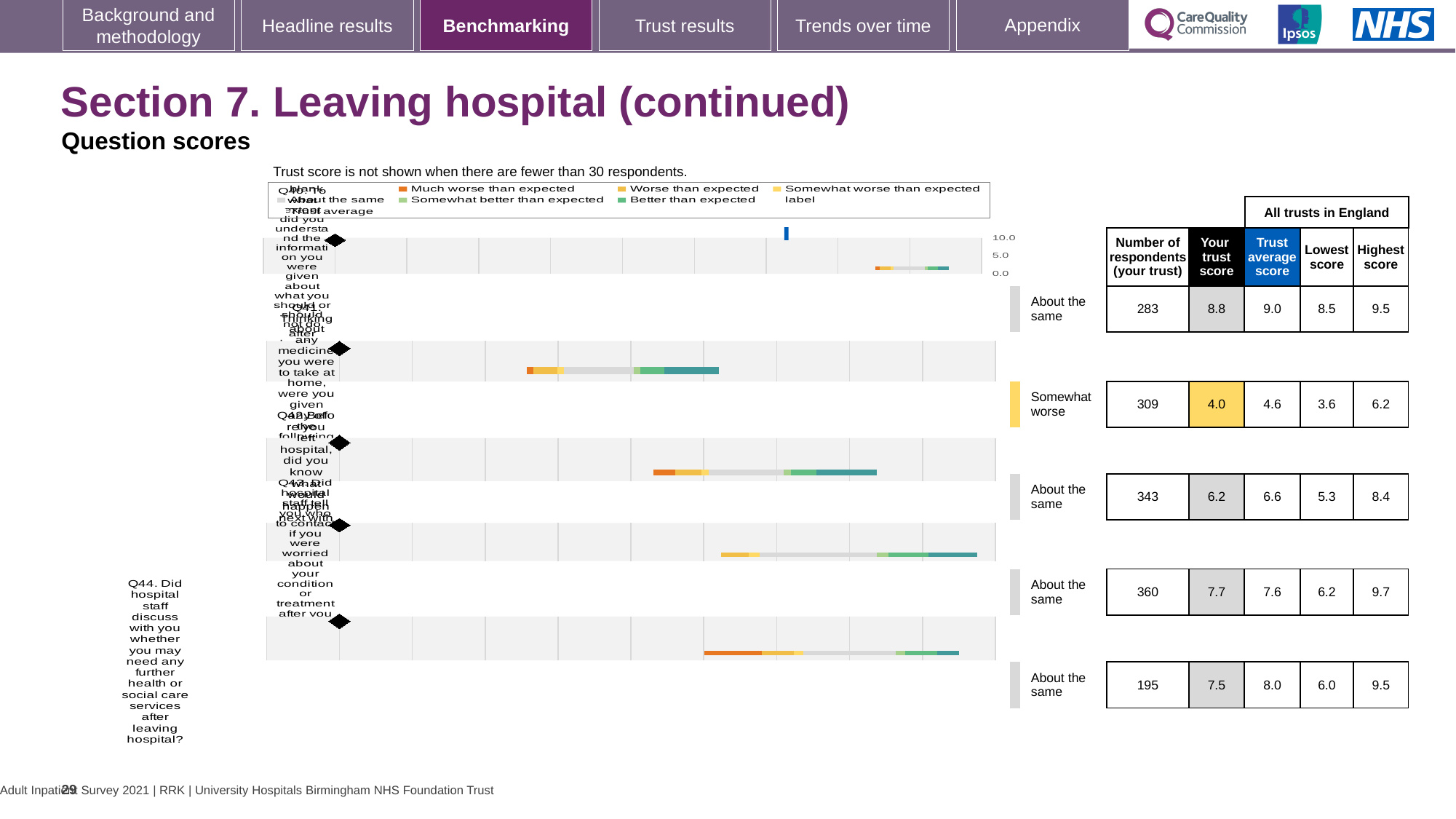
What is the lowest score across all trusts in England for the fourth question row (360 respondents)? 6.2 How many respondents from the trust answered Q44? 195 What is the 'Your trust score' for the first question row on the slide? 8.8 What is the difference between the highest 'Your trust score' (8.8) and the lowest (4.0) on the slide? 4.8 Which question row is rated 'Somewhat worse' than expected? The second row (trust score 4.0) What is the 'Your trust score' for Q44 (Did hospital staff discuss with you whether you may need any further health or social care services after leaving hospital?)? 7.5 For Q44, which is larger: the trust's own score or the trust average score? Trust average score (8.0) What is the trust average score for Q44? 8.0 How many question rows are shown on the slide? 5 What is the highest score across all trusts in England for Q44? 9.5 Which question row has the lowest 'Your trust score'? The second row (score 4.0) What kind of chart is used to show the question scores? Horizontal bar chart